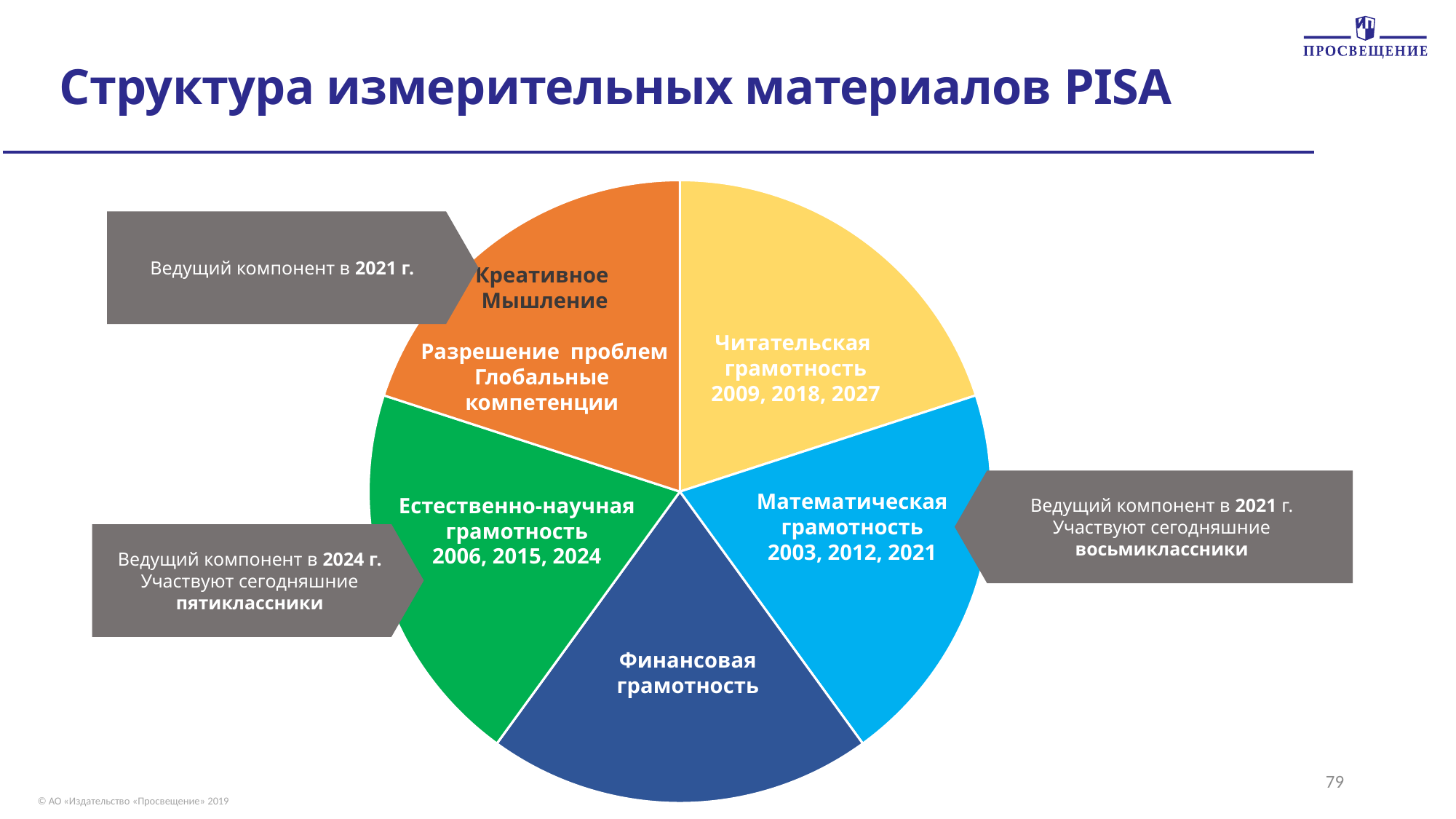
Which years are printed on the slice «Читательская грамотность»? 2009, 2018, 2027 Which years are printed on the slice «Математическая грамотность»? 2003, 2012, 2021 How many slices does the pie chart have? 5 Which years are printed on the slice «Естественно-научная грамотность»? 2006, 2015, 2024 Which slice of the pie chart is labelled «Креативное мышление»? the orange slice Which slice of the pie chart is coloured green? Естественно-научная грамотность What kind of chart is shown on the slide? pie chart Which slice of the pie chart is coloured yellow? Читательская грамотность What is the title of the slide containing the pie chart? Структура измерительных материалов PISA Which colour is the slice labelled «Финансовая грамотность»? dark blue